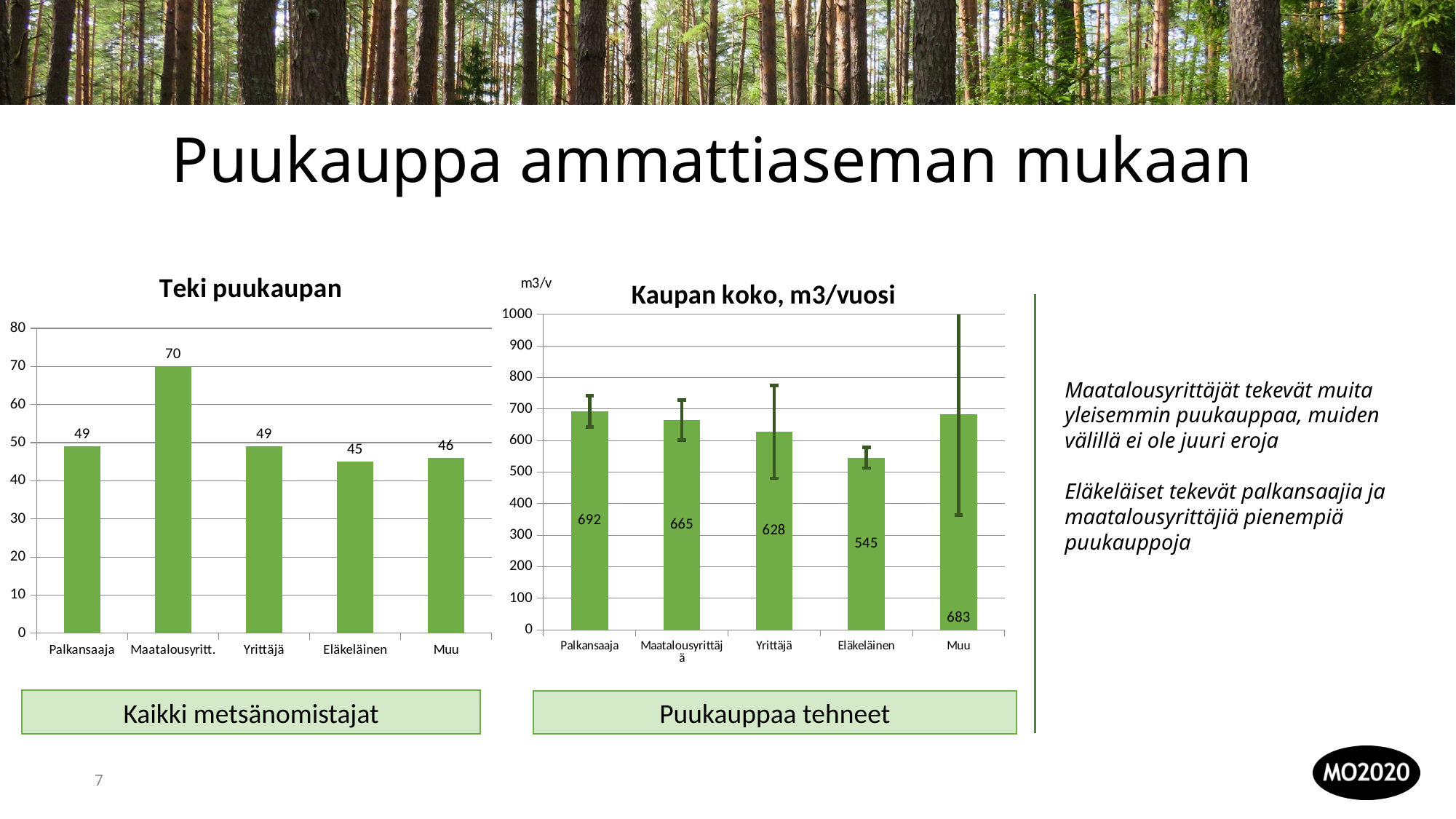
In the 'Kaupan koko, m3/vuosi' chart, what is the value for Eläkeläinen? 545 In the 'Teki puukaupan' chart, what is the difference between Maatalousyritt. and Palkansaaja? 21 In the 'Teki puukaupan' chart, how many categories are shown on the x axis? 5 What is the label in the box below the left chart? Kaikki metsänomistajat In the 'Teki puukaupan' chart, what is the value for Muu? 46 In the 'Kaupan koko, m3/vuosi' chart, which category has the highest value? Palkansaaja In the 'Teki puukaupan' chart, what is the value for Maatalousyritt.? 70 In the 'Kaupan koko, m3/vuosi' chart, what is the value for Maatalousyrittäjä? 665 In the 'Teki puukaupan' chart, which category has the lowest value? Eläkeläinen In the 'Kaupan koko, m3/vuosi' chart, which is larger: Yrittäjä or Muu? Muu What kind of chart is 'Kaupan koko, m3/vuosi'? Bar chart In the 'Kaupan koko, m3/vuosi' chart, what is the difference between Palkansaaja and Eläkeläinen? 147